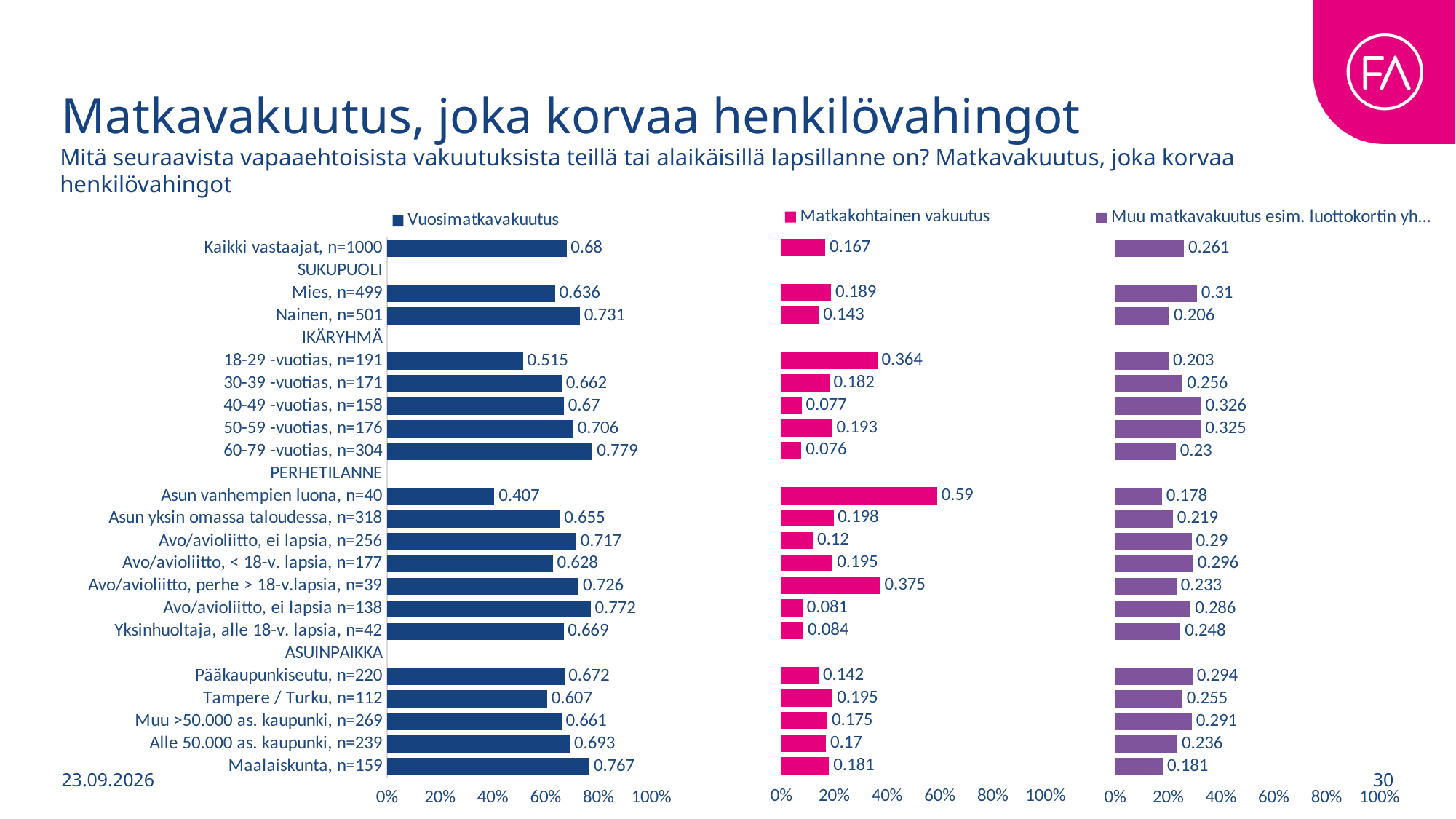
What kind of chart is the Matkakohtainen vakuutus chart? bar chart In the Matkakohtainen vakuutus chart, which is larger: the value for 18-29 -vuotias, n=191 or 60-79 -vuotias, n=304? 18-29 -vuotias, n=191 In the Vuosimatkavakuutus chart, what is the value for Kaikki vastaajat, n=1000? 0.68 What colour are the bars in the Matkakohtainen vakuutus chart? pink In the Vuosimatkavakuutus chart, what is the difference between the values for Nainen, n=501 and Mies, n=499? 0.095 In the Matkakohtainen vakuutus chart, what is the value for 18-29 -vuotias, n=191? 0.364 In the Muu matkavakuutus chart (rightmost), is the value for Maalaiskunta, n=159 greater or less than 20%? less In the Vuosimatkavakuutus chart, which category has the highest value? 60-79 -vuotias, n=304 How many categories with bars are plotted in the Vuosimatkavakuutus chart? 20 In the Matkakohtainen vakuutus chart, which category has the highest value? Asun vanhempien luona, n=40 In the Muu matkavakuutus chart (rightmost), what is the value for Mies, n=499? 0.31 In the Vuosimatkavakuutus chart, which category has the lowest value? Asun vanhempien luona, n=40